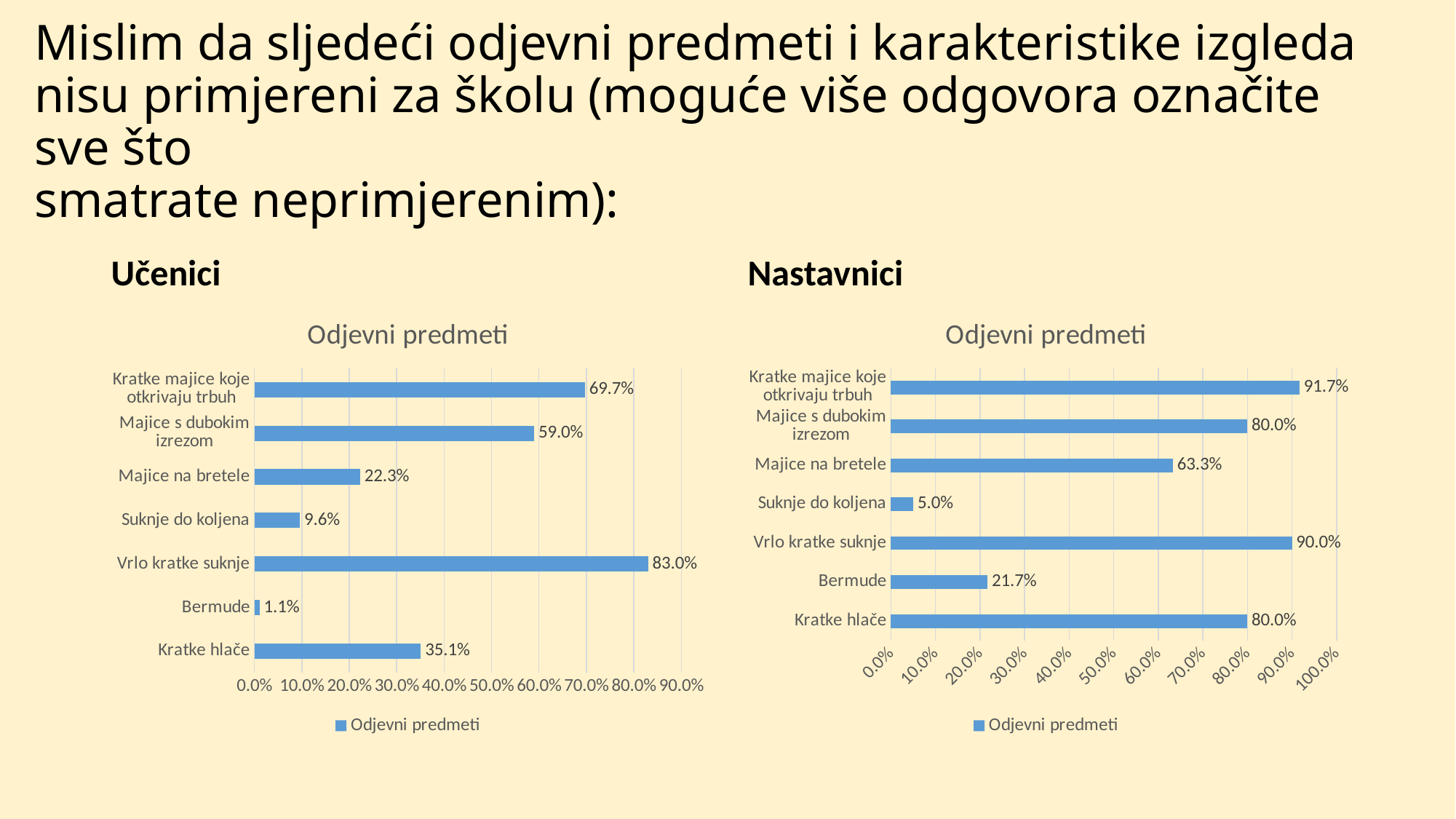
What is the title of the Nastavnici chart on the right? Odjevni predmeti How many series does the legend of the Nastavnici chart on the right list? 1 In the Učenici chart on the left, is the value for Kratke hlače greater or less than 30.0%? greater In the Nastavnici chart on the right, what is the value for Kratke majice koje otkrivaju trbuh? 91.7% In the Učenici chart on the left, what is the difference between Kratke majice koje otkrivaju trbuh and Majice s dubokim izrezom? 10.7% What type of chart is the Učenici chart on the left? Bar chart In the Učenici chart on the left, what is the value for Vrlo kratke suknje? 83.0% How many categories does the Učenici chart on the left show? 7 In the Nastavnici chart on the right, which category has the lowest value? Suknje do koljena In the Nastavnici chart on the right, which category has the highest value? Kratke majice koje otkrivaju trbuh In the Nastavnici chart on the right, which is larger: Majice na bretele or Bermude? Majice na bretele In the Učenici chart on the left, which category has the lowest value? Bermude